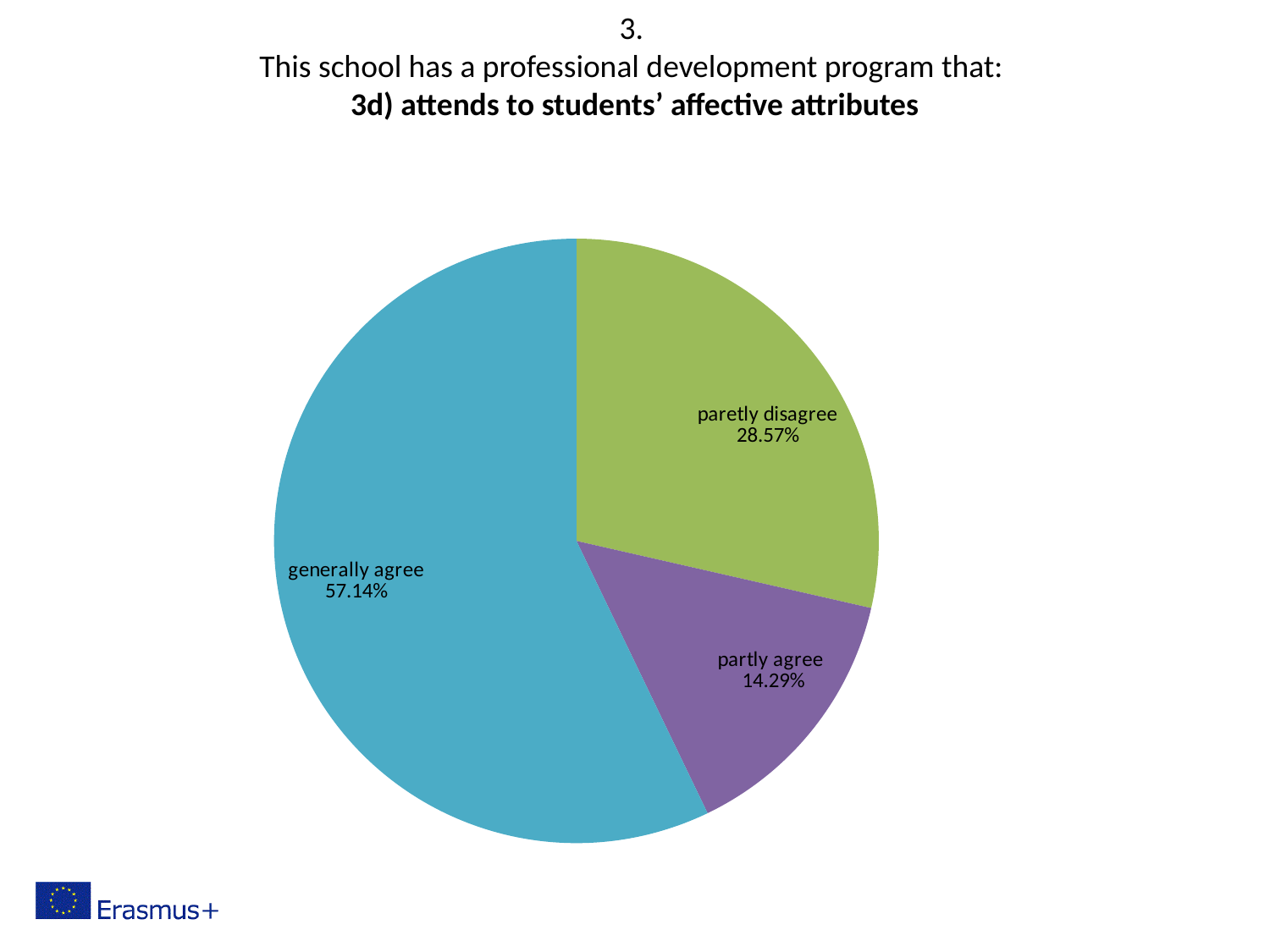
Which slice of the pie is the largest? generally agree What is the difference in percentage points between the "paretly disagree" and "partly agree" slices? 14.28 What is the difference in percentage points between the "generally agree" and "paretly disagree" slices? 28.57 What colour is the "partly agree" slice? purple What kind of chart is shown on the slide? pie chart How many slices does the pie chart have? 3 What share of the pie is labelled "paretly disagree"? 28.57% What colour is the "generally agree" slice? blue Which slice of the pie is the smallest? partly agree What share of the pie is labelled "partly agree"? 14.29% Which is larger, the "paretly disagree" slice or the "partly agree" slice? paretly disagree What share of the pie is labelled "generally agree"? 57.14%